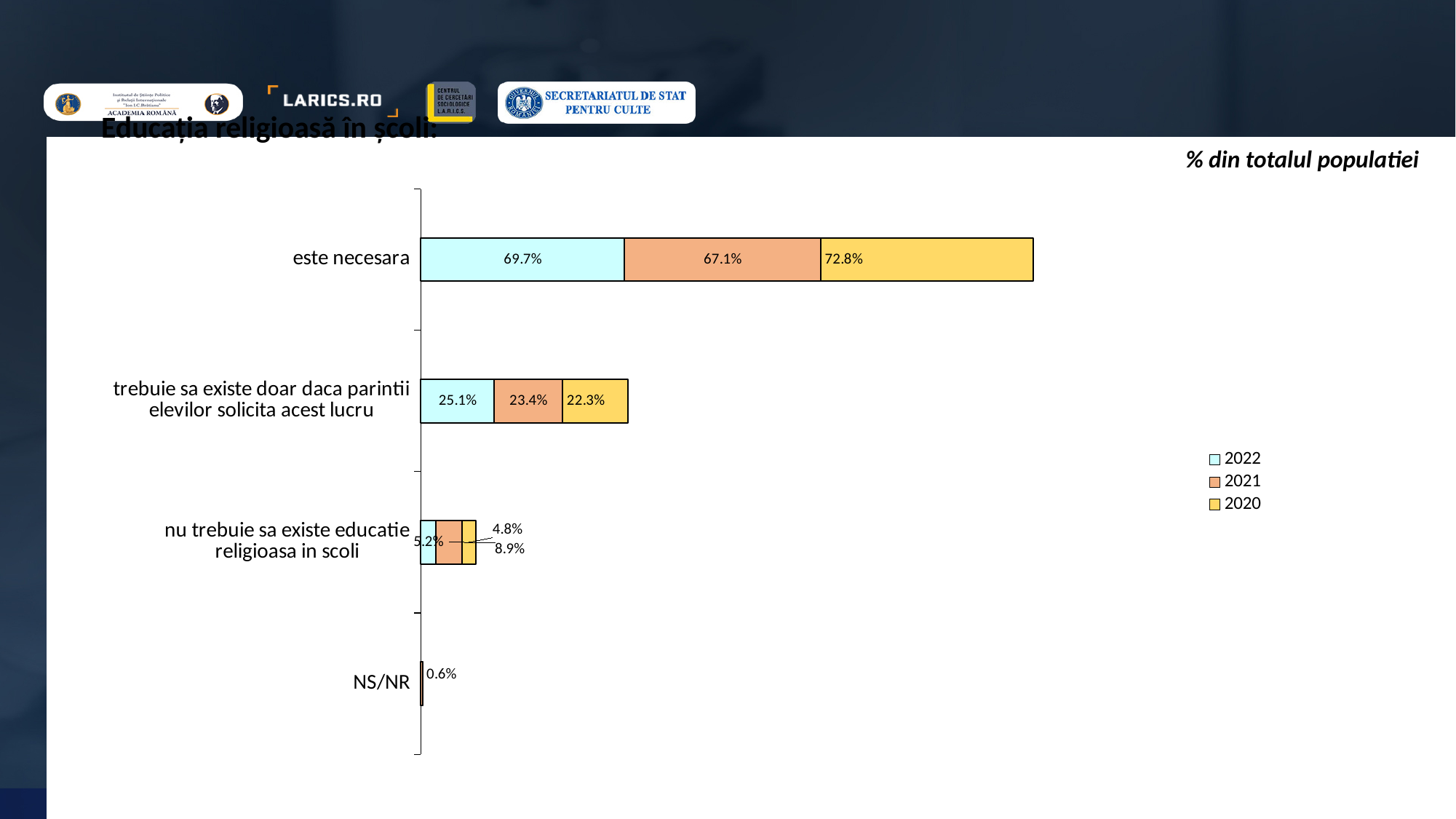
What is the 2022 value for "nu trebuie sa existe educatie religioasa in scoli"? 5.2% What is the 2021 value for "trebuie sa existe doar daca parintii elevilor solicita acest lucru"? 23.4% What are the entries listed in the chart legend? 2022, 2021, 2020 How many categories are shown on the vertical axis of the chart? 4 How many series does the legend list? 3 What is the 2022 value for "este necesara"? 69.7% What is the 2020 value for "este necesara"? 72.8% For "trebuie sa existe doar daca parintii elevilor solicita acest lucru", which is larger: the 2022 value or the 2020 value? 2022 What is the difference between the 2022 and 2021 values for "este necesara"? 2.6 percentage points What is the total of the stacked bar for "trebuie sa existe doar daca parintii elevilor solicita acest lucru"? 70.8% What kind of chart is shown on the slide? Stacked bar chart For "este necesara", which year has the highest value? 2020